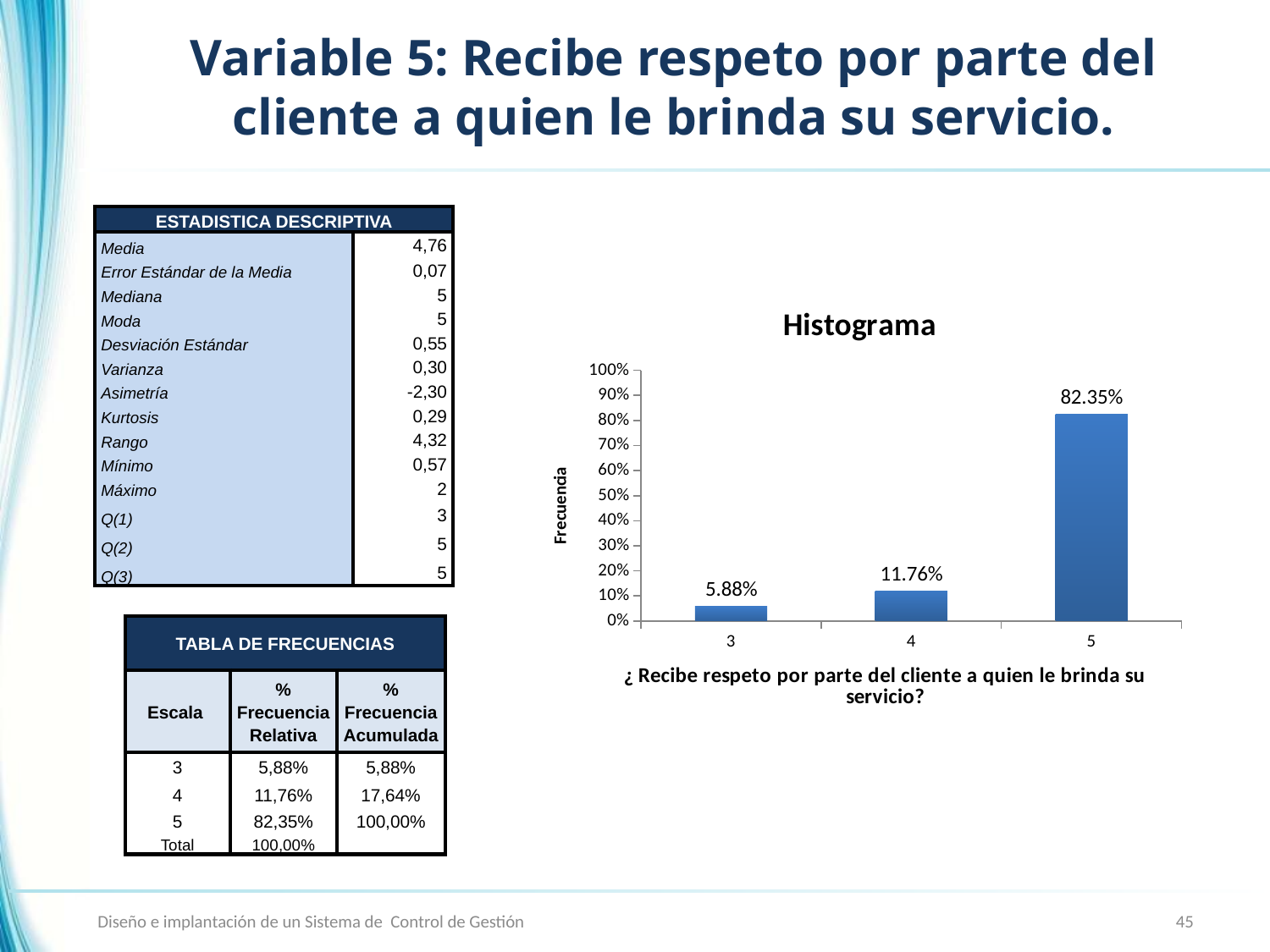
Is the value for category 5 in the Histograma chart greater or less than 80%? greater Which is larger in the Histograma chart, the value for category 3 or category 4? 4 Which category has the highest value in the Histograma chart? 5 What is the difference between the values for category 4 and category 3 in the Histograma chart? 5.88% What is the difference between the values for category 5 and category 4 in the Histograma chart? 70.59% What is the value for category 3 in the Histograma chart? 5.88% What is the value for category 4 in the Histograma chart? 11.76% Which category has the lowest value in the Histograma chart? 3 What is the y-axis label of the Histograma chart? Frecuencia What is the value for category 5 in the Histograma chart? 82.35% How many categories are shown on the x axis of the Histograma chart? 3 What kind of chart is the Histograma chart? bar chart